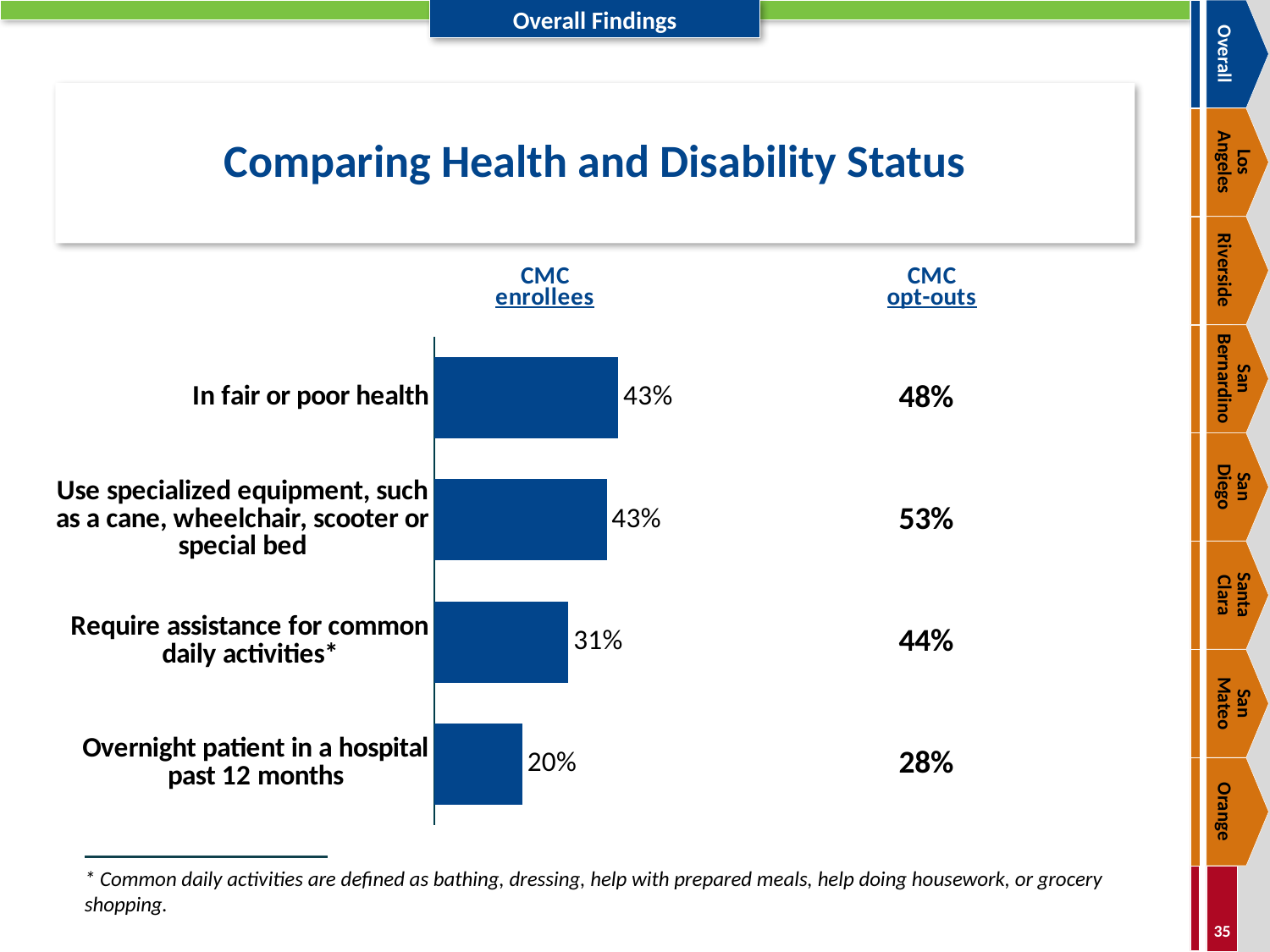
What percentage of CMC opt-outs are in fair or poor health? 48% What is the title of the chart on the slide? Comparing Health and Disability Status What percentage of CMC enrollees were an overnight patient in a hospital in the past 12 months? 20% How many categories are shown in the chart? 4 Which is larger for CMC enrollees: 'Require assistance for common daily activities' or 'Overnight patient in a hospital past 12 months'? Require assistance for common daily activities What percentage of CMC enrollees require assistance for common daily activities? 31% For 'Require assistance for common daily activities', what is the difference between the CMC opt-outs value and the CMC enrollees value? 13 percentage points What is the difference between the CMC enrollees value for 'In fair or poor health' and for 'Overnight patient in a hospital past 12 months'? 23 percentage points What kind of chart is used to show the CMC enrollees values? Bar chart Which category has the lowest value for CMC enrollees? Overnight patient in a hospital past 12 months What percentage of CMC opt-outs use specialized equipment, such as a cane, wheelchair, scooter or special bed? 53% What percentage of CMC enrollees are in fair or poor health? 43%